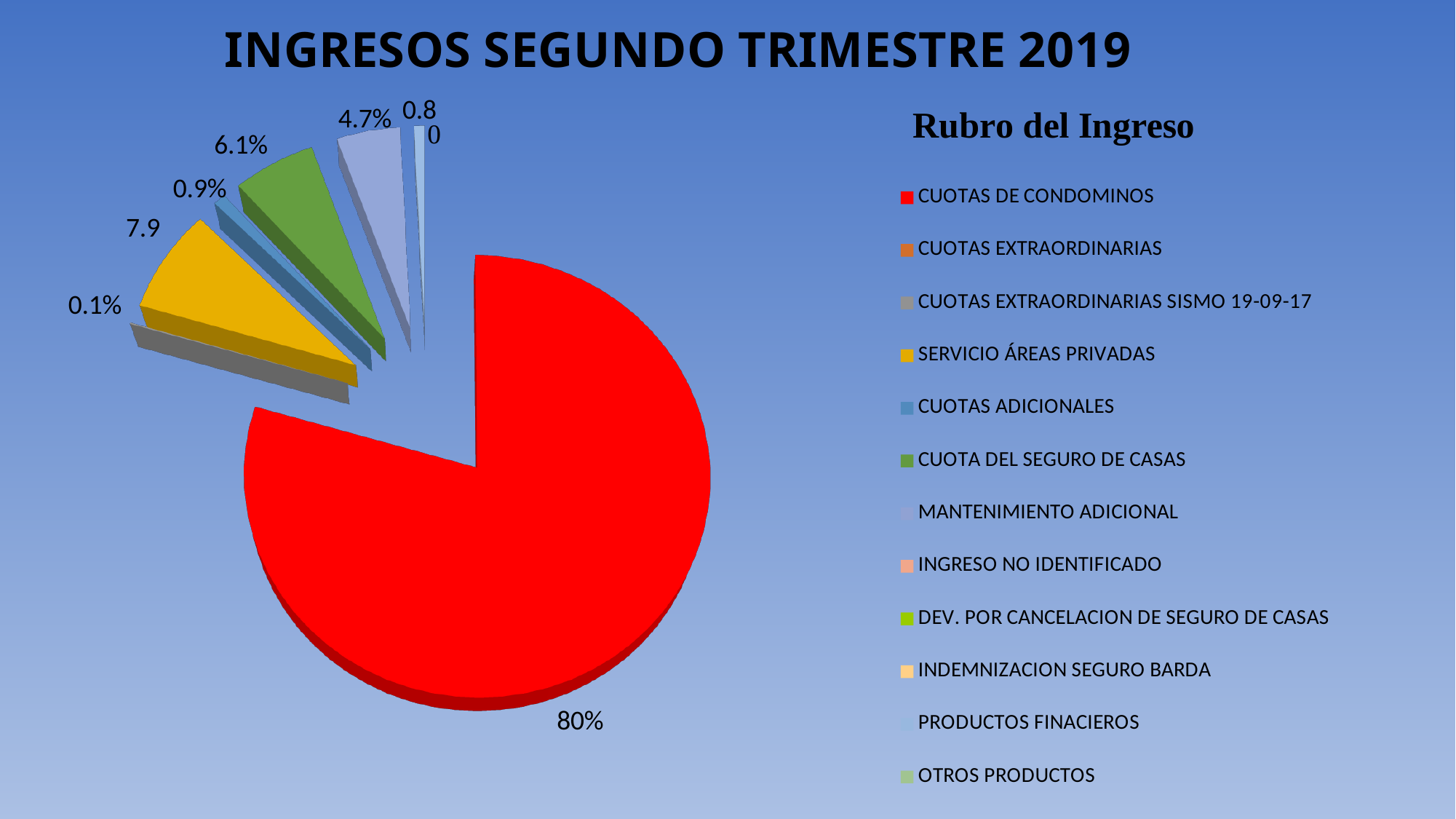
Which is larger, the slice for CUOTA DEL SEGURO DE CASAS or the slice for MANTENIMIENTO ADICIONAL? CUOTA DEL SEGURO DE CASAS What value is labelled on the MANTENIMIENTO ADICIONAL slice? 4.7% What is the difference between the CUOTA DEL SEGURO DE CASAS value and the MANTENIMIENTO ADICIONAL value? 1.4% How many categories does the legend list? 12 What kind of chart is shown on the slide? pie chart Which category has the largest slice of the pie? CUOTAS DE CONDOMINOS What value is labelled on the CUOTAS ADICIONALES slice? 0.9% What value is labelled on the CUOTA DEL SEGURO DE CASAS slice? 6.1% What is the title of the chart? INGRESOS SEGUNDO TRIMESTRE 2019 What share of the pie does CUOTAS DE CONDOMINOS represent? 80% What is the heading shown above the legend? Rubro del Ingreso What value is labelled on the SERVICIO ÁREAS PRIVADAS slice? 7.9